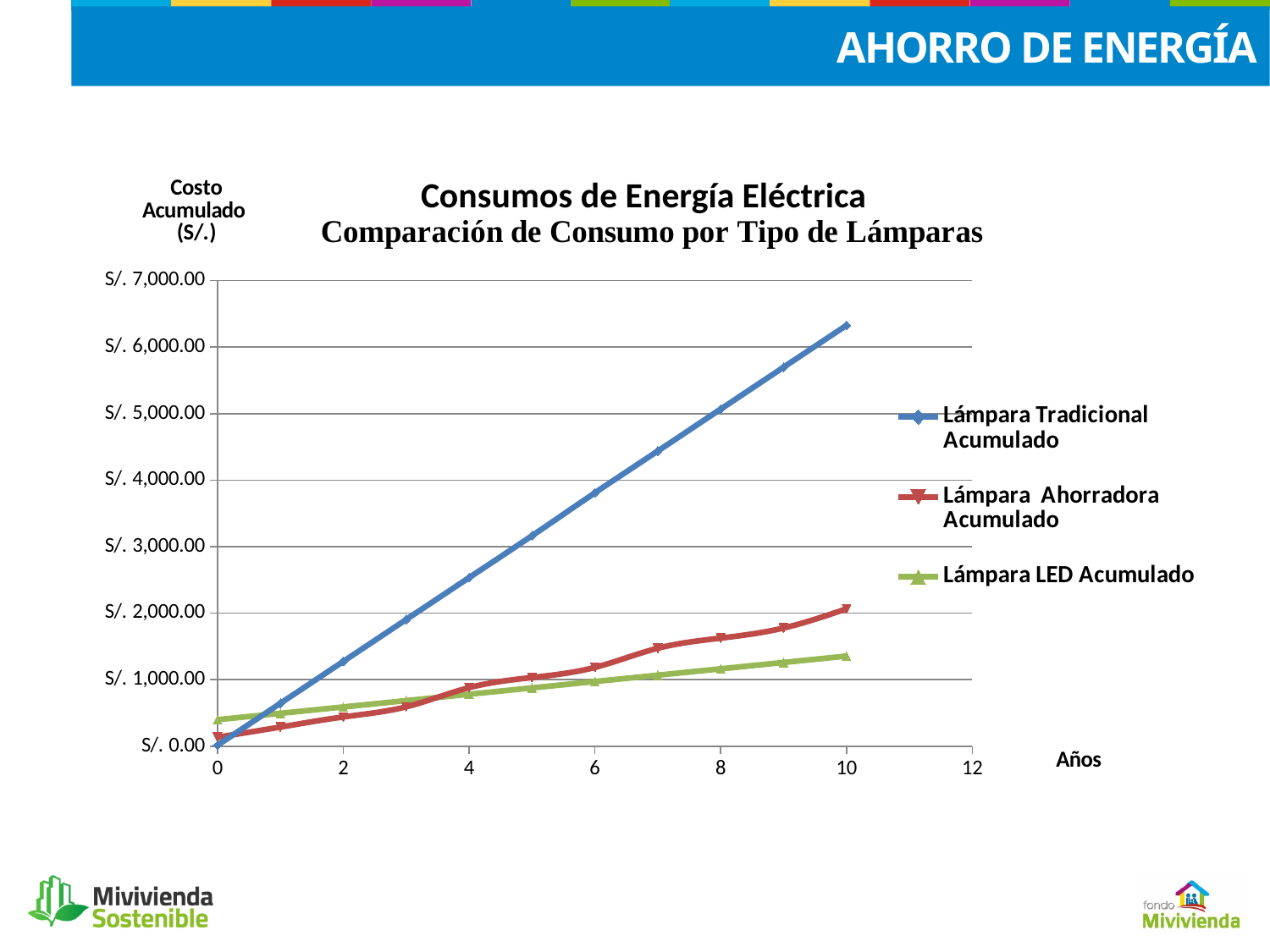
At year 0, which is larger: Lámpara LED Acumulado or Lámpara Tradicional Acumulado? Lámpara LED Acumulado Do the values for Lámpara Tradicional Acumulado rise or fall as the years increase? Rise At year 10, which is larger: Lámpara Tradicional Acumulado or Lámpara LED Acumulado? Lámpara Tradicional Acumulado Is the value for Lámpara Ahorradora Acumulado at year 10 greater or less than S/. 3,000.00? less What kind of chart is shown on the slide? Line chart Is the value for Lámpara Tradicional Acumulado at year 6 greater or less than S/. 3,000.00? greater How many series does the legend list? 3 Is the value for Lámpara LED Acumulado at year 10 greater or less than S/. 1,000.00? greater What is the label of the x axis? Años Which series has the lowest value at year 10? Lámpara LED Acumulado Which series has the highest value at year 10? Lámpara Tradicional Acumulado